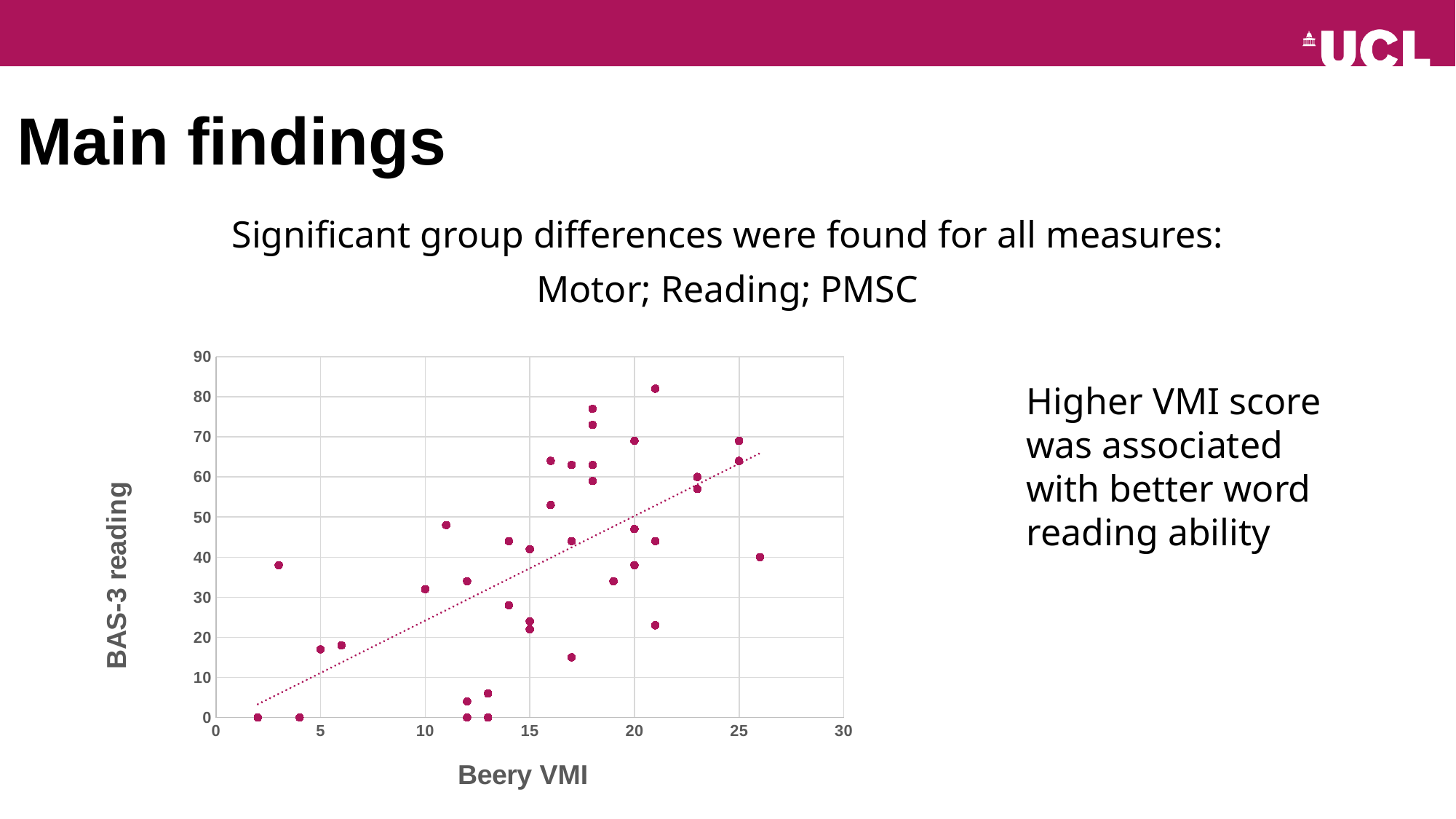
Is the highest BAS-3 reading value plotted greater or less than 70? greater Is the BAS-3 reading value for the point with the highest Beery VMI score greater or less than 50? less Is the BAS-3 reading value for the point with the highest Beery VMI score greater or less than 30? greater What kind of chart is shown on the slide? Scatter plot What is the maximum value shown on the y axis of the chart? 90 What is the label of the y axis of the chart? BAS-3 reading Does BAS-3 reading tend to rise or fall as Beery VMI increases along the x axis? Rise What is the label of the x axis of the chart? Beery VMI